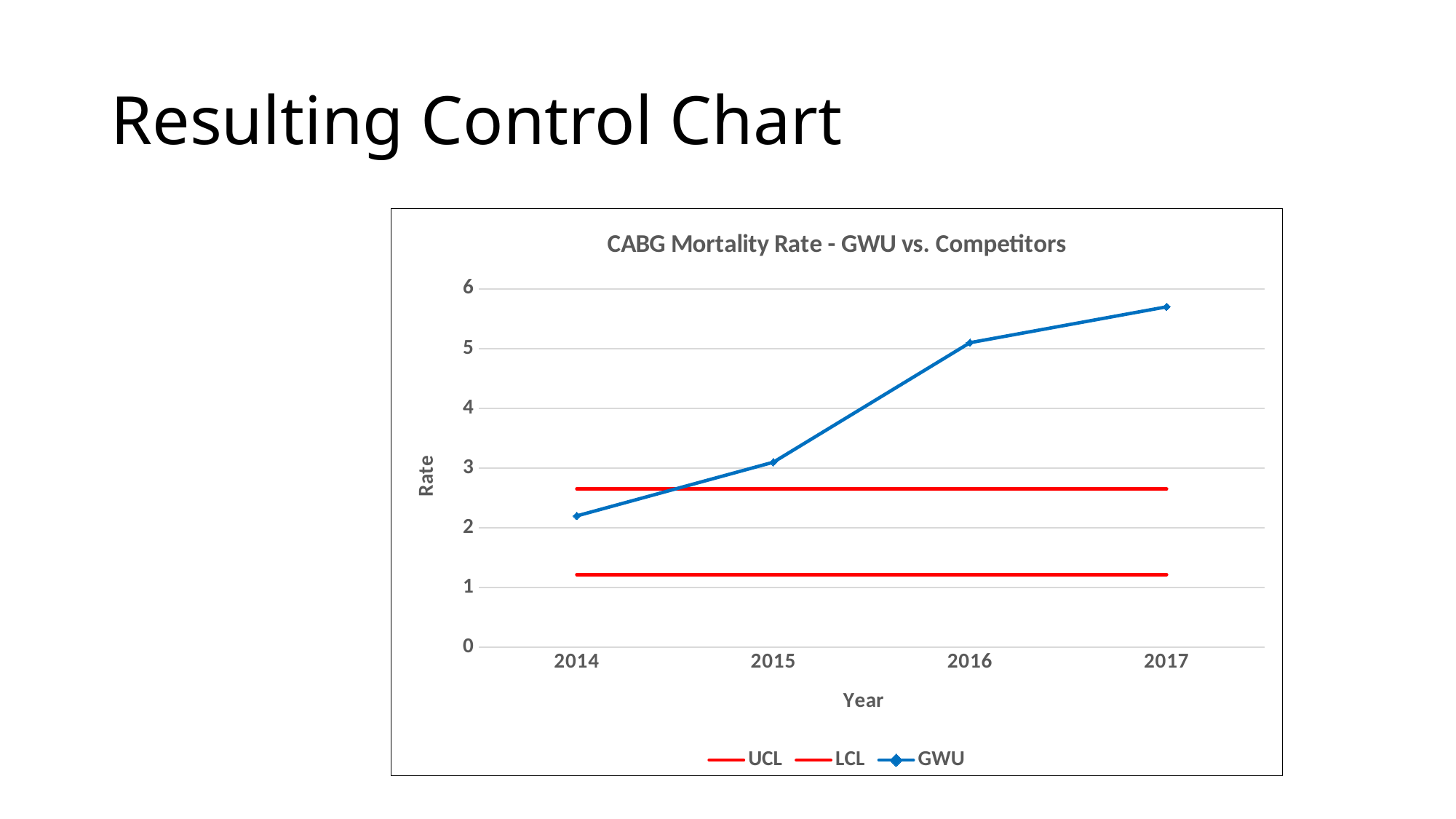
Is the GWU value for 2016 greater or less than 4? greater In which year is the GWU value highest? 2017 In which year is the GWU value lowest? 2014 What is the title of the chart? CABG Mortality Rate - GWU vs. Competitors Which is larger, the GWU value for 2015 or for 2016? 2016 What kind of chart is shown on the slide? line chart How many years are shown on the x axis? 4 Is the UCL line greater or less than 3? less Does the GWU line rise or fall from 2014 to 2017? rise Is the GWU value for 2014 greater or less than 3? less How many series does the legend list? 3